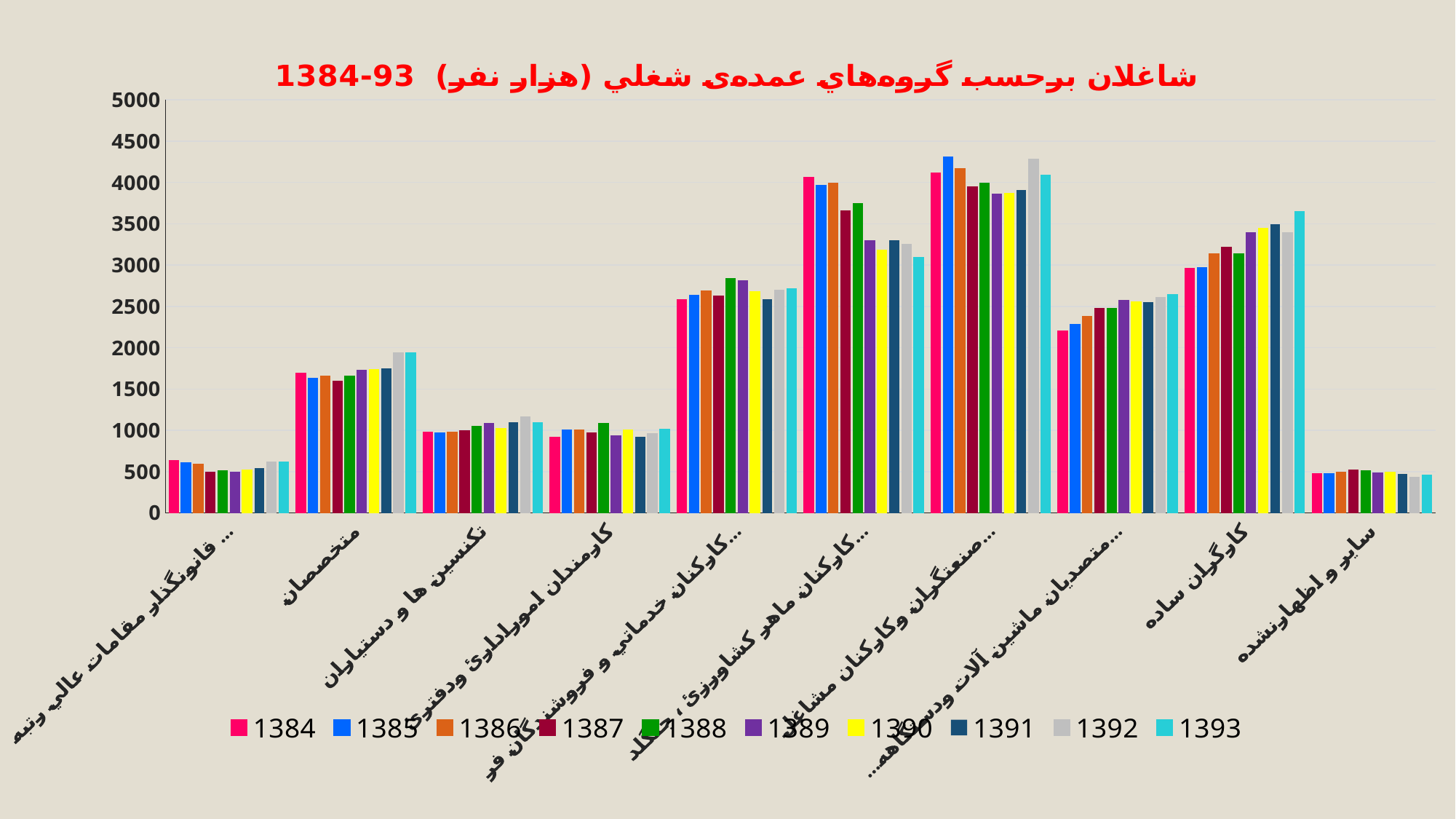
What kind of chart is shown on the slide? bar chart Which colour represents the year 1390 in the legend? yellow How many occupational categories are shown along the x axis? 10 For كارگران ساده, do the values generally rise or fall from 1384 to 1393? rise In 1384, which has the larger value, متخصصان or تكنسين ها و دستياران? متخصصان Is the value for كارمندان امورادارى ودفترى in 1388 greater or less than 1000? greater In 1393, which category has the lowest value? ساير و اظهارنشده How many series does the legend list? 10 For كارگران ساده, which year has the larger value, 1384 or 1393? 1393 Is the value for ساير و اظهارنشده in 1384 greater or less than 1000? less Is the value for كارگران ساده in 1393 greater or less than 3500? greater